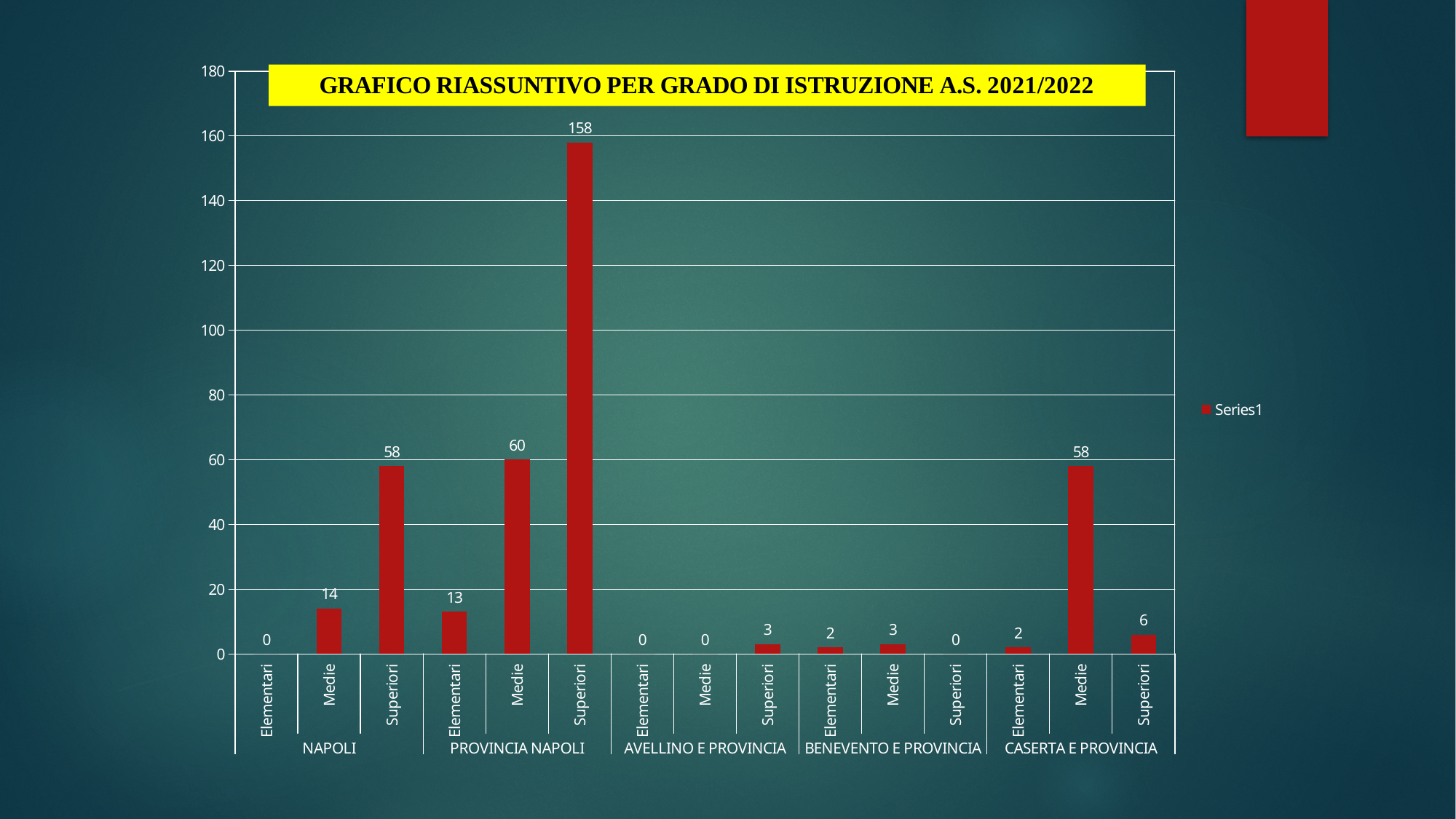
What is the difference between Superiori in PROVINCIA NAPOLI and Medie in PROVINCIA NAPOLI? 98 What kind of chart is shown on the slide? Bar chart Which is larger: Medie in CASERTA E PROVINCIA or Superiori in NAPOLI? They are equal (58) Which bar has the highest value on the chart? Superiori, PROVINCIA NAPOLI What is the value for Superiori in PROVINCIA NAPOLI? 158 What is the title of the chart? GRAFICO RIASSUNTIVO PER GRADO DI ISTRUZIONE A.S. 2021/2022 How many series does the legend list? 1 What is the value for Elementari in PROVINCIA NAPOLI? 13 Which is larger: Medie in PROVINCIA NAPOLI or Superiori in NAPOLI? Medie in PROVINCIA NAPOLI How many region groups are shown on the x axis? 5 What is the value for Superiori in CASERTA E PROVINCIA? 6 What is the value for Medie in NAPOLI? 14